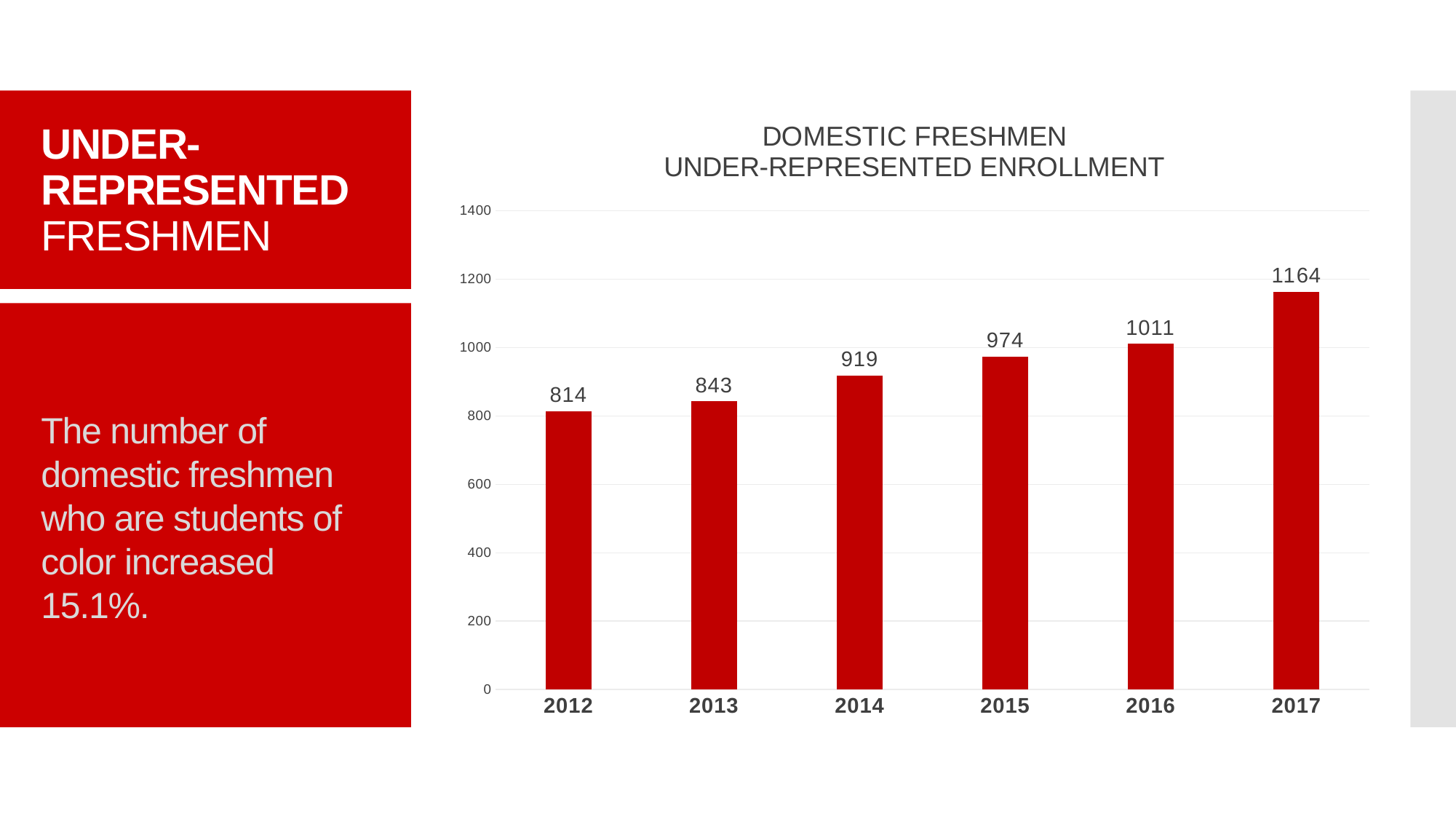
What is the difference between the values for 2017 and 2016? 153 What kind of chart is shown? bar chart What is the value for 2015? 974 Do the values rise or fall from 2012 to 2017? rise Which is larger, the value for 2014 or the value for 2016? 2016 What is the value for 2017? 1164 What is the difference between the values for 2014 and 2013? 76 Which year has the lowest value? 2012 Which year has the highest value? 2017 What is the value for 2012? 814 How many years are shown on the x axis? 6 Is the value for 2016 greater or less than 1000? greater